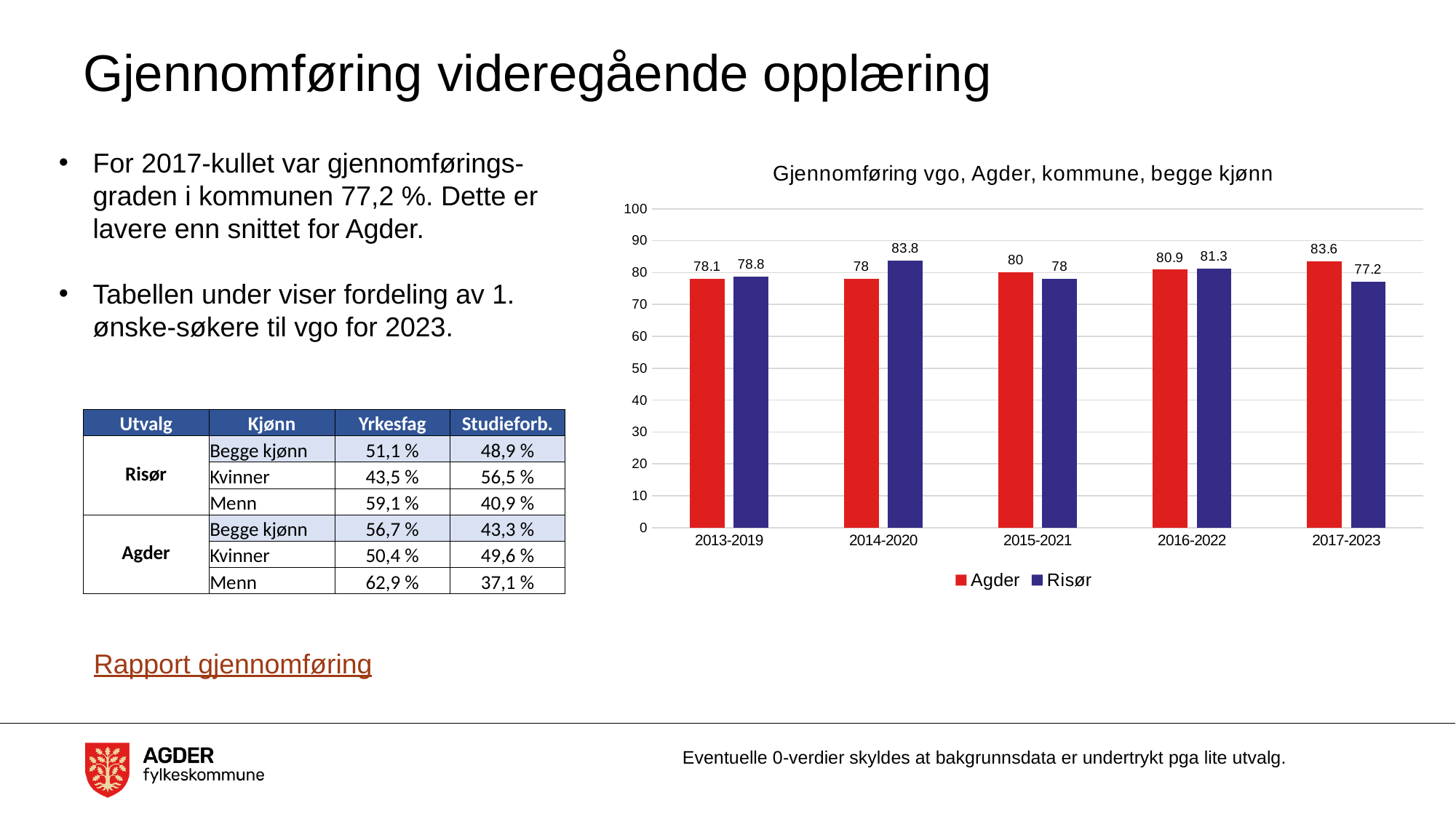
Which period has the highest value for Agder? 2017-2023 What is the value for Agder in 2013-2019? 78.1 Which period has the lowest value for Risør? 2017-2023 Is the value for Risør in 2016-2022 greater or less than 70? greater Which is larger in 2014-2020, Agder or Risør? Risør What is the title of the chart? Gjennomføring vgo, Agder, kommune, begge kjønn What is the value for Risør in 2014-2020? 83.8 How many series does the legend list? 2 What kind of chart is shown? bar chart What is the difference between Agder and Risør in 2017-2023? 6.4 What is the value for Risør in 2017-2023? 77.2 How many periods are shown on the x axis? 5